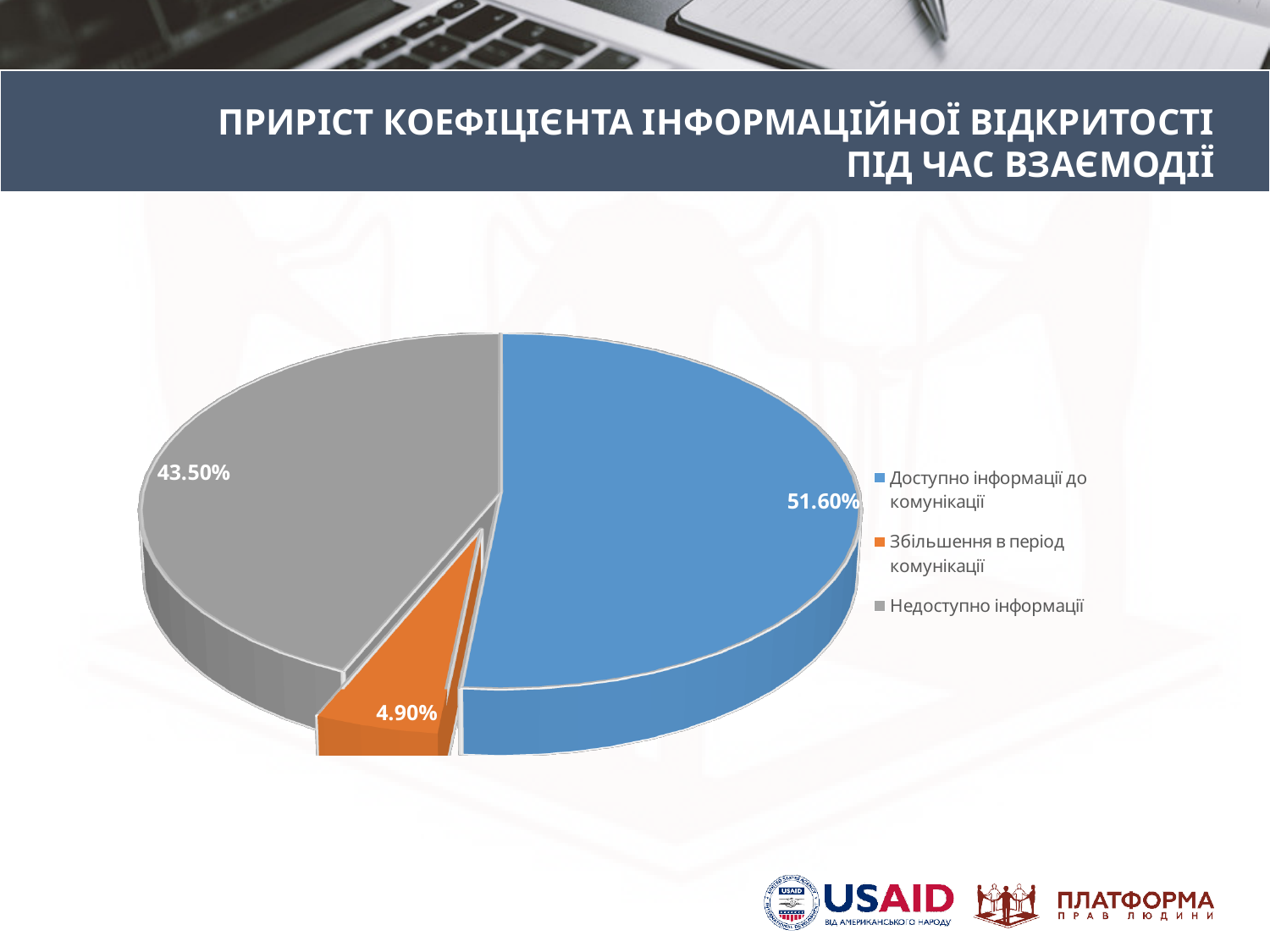
Which category has the smallest slice of the pie? Збільшення в період комунікації What is the value for "Недоступно інформації"? 43.50% What kind of chart is shown on the slide? Pie chart What is the value for "Збільшення в період комунікації"? 4.90% What is the value for "Доступно інформації до комунікації"? 51.60% How many slices does the pie chart have? 3 What is the difference between the values for "Недоступно інформації" and "Збільшення в період комунікації"? 38.60% Which category has the largest slice of the pie? Доступно інформації до комунікації What is the title of the slide containing the chart? ПРИРІСТ КОЕФІЦІЄНТА ІНФОРМАЦІЙНОЇ ВІДКРИТОСТІ ПІД ЧАС ВЗАЄМОДІЇ What is the difference between the values for "Доступно інформації до комунікації" and "Недоступно інформації"? 8.10% What colour is the slice for "Збільшення в період комунікації"? Orange Which is larger: "Недоступно інформації" or "Збільшення в період комунікації"? Недоступно інформації